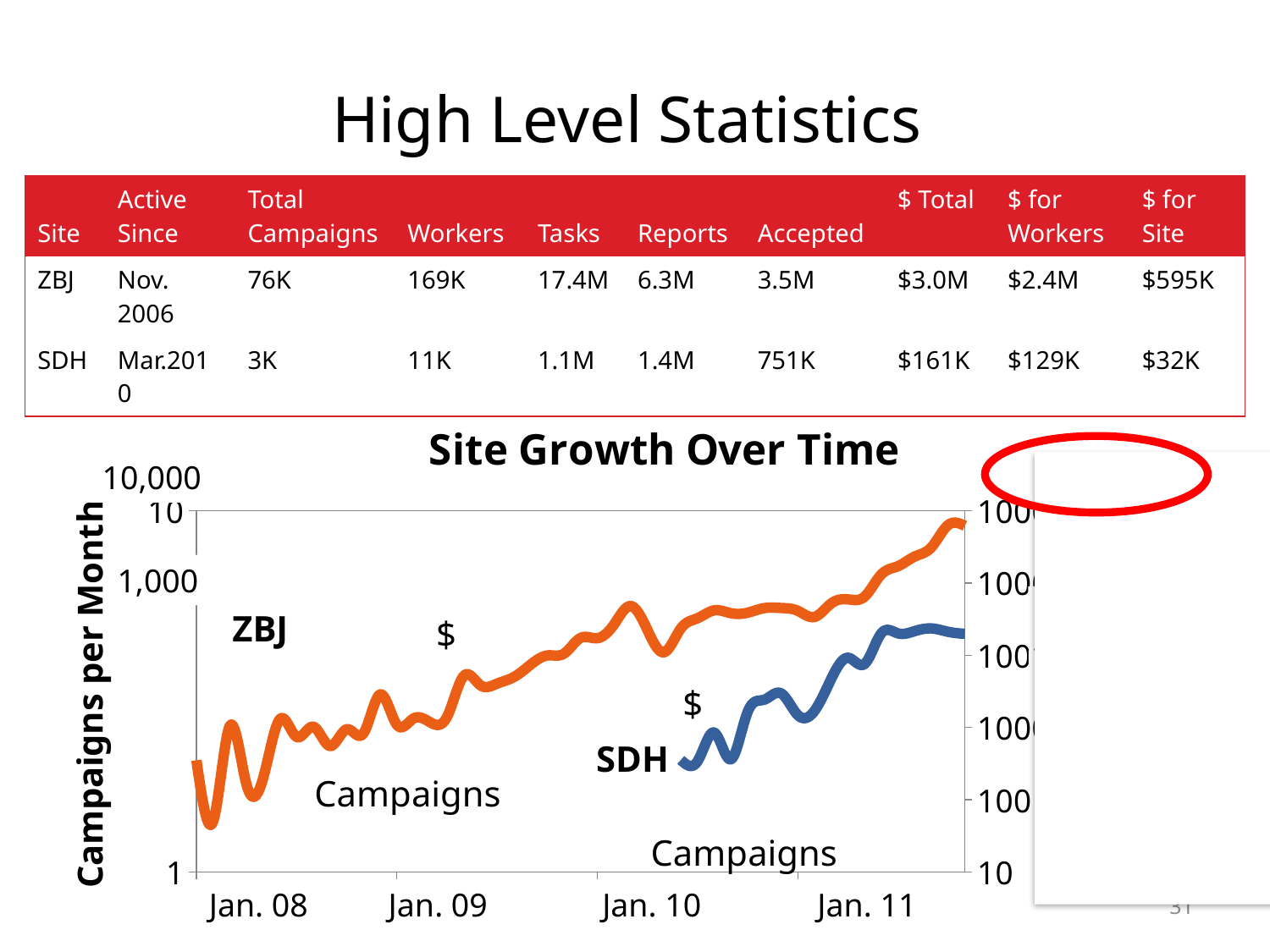
In the 'Site Growth Over Time' chart, does the ZBJ campaigns line generally rise or fall from Jan. 08 to Jan. 11? Rise How many sites (lines) are plotted in the 'Site Growth Over Time' chart? 2 In the 'Site Growth Over Time' chart, is the SDH campaigns per month value at Jan. 11 greater or less than 1,000? less In the 'Site Growth Over Time' chart, does the SDH campaigns line rise or fall over time? Rise What kind of chart is 'Site Growth Over Time'? Line chart What is the label of the vertical axis in the 'Site Growth Over Time' chart? Campaigns per Month In the 'Site Growth Over Time' chart, which site has more campaigns per month at Jan. 11, ZBJ or SDH? ZBJ In the 'Site Growth Over Time' chart, which site's line starts later on the x axis, ZBJ or SDH? SDH What is the title of the chart on the slide? Site Growth Over Time In the 'Site Growth Over Time' chart, which site has the lowest campaigns per month at the start of the chart (around Jan. 08)? ZBJ How many year labels are shown on the x axis of the 'Site Growth Over Time' chart? 4